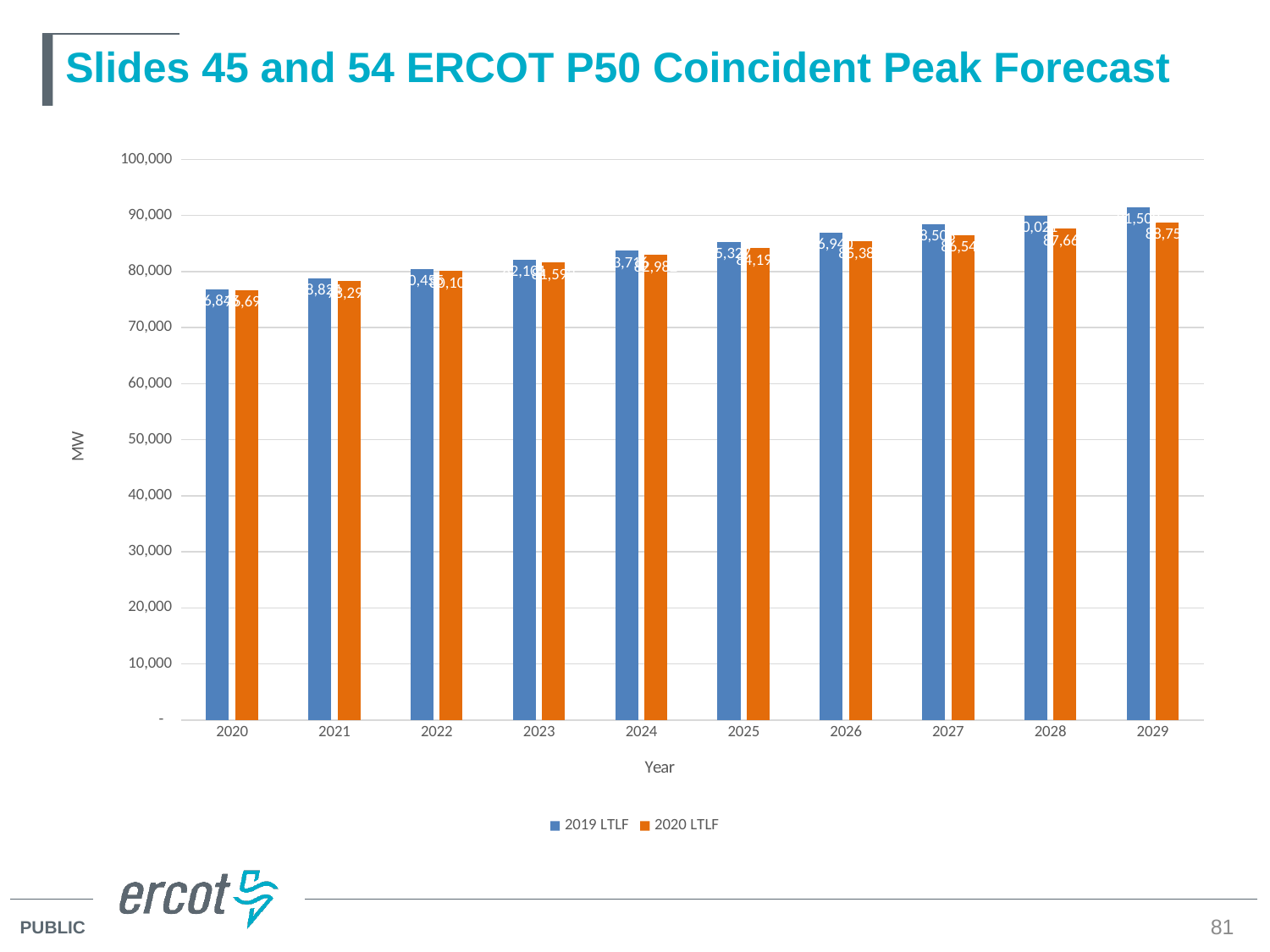
Do the 2020 LTLF values rise or fall from 2020 to 2029? rise Which year has the lowest value for the 2020 LTLF series? 2020 What is the label on the vertical axis of the chart? MW Is the 2020 LTLF value for 2020 greater or less than 80,000? less Which year has the highest value for the 2019 LTLF series? 2029 Is the 2019 LTLF value for 2029 greater or less than 90,000? greater In 2029, which series has the larger value, 2019 LTLF or 2020 LTLF? 2019 LTLF How many years are shown on the x axis? 10 In 2028, which series has the larger value, 2019 LTLF or 2020 LTLF? 2019 LTLF Is the 2020 LTLF value for 2029 greater or less than 90,000? less What kind of chart is shown on the slide? bar chart How many series does the legend list? 2